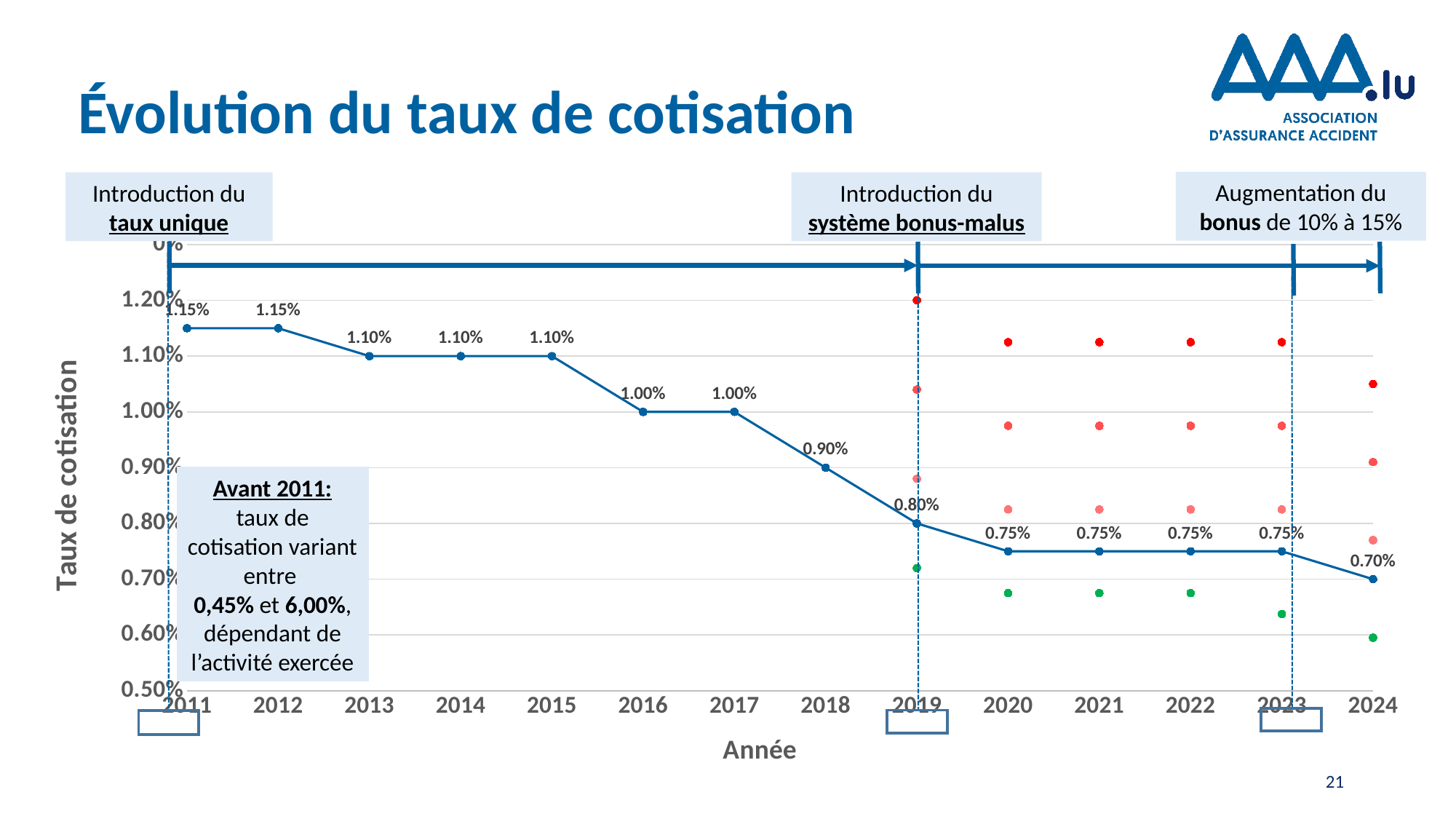
What is the difference between the taux de cotisation in 2011 and in 2024? 0.45% What is the taux de cotisation for 2011? 1.15% What is the title of the x axis? Année Does the taux de cotisation rise or fall from 2011 to 2024? Fall What kind of chart is this? Line chart What is the taux de cotisation for 2024? 0.70% Which is larger, the taux de cotisation in 2013 or in 2017? 2013 How many years are shown on the x axis? 14 What is the difference between the taux de cotisation in 2015 and in 2016? 0.10% What is the taux de cotisation for 2018? 0.90% What is the taux de cotisation for 2019? 0.80% Which year has the lowest taux de cotisation on the line? 2024